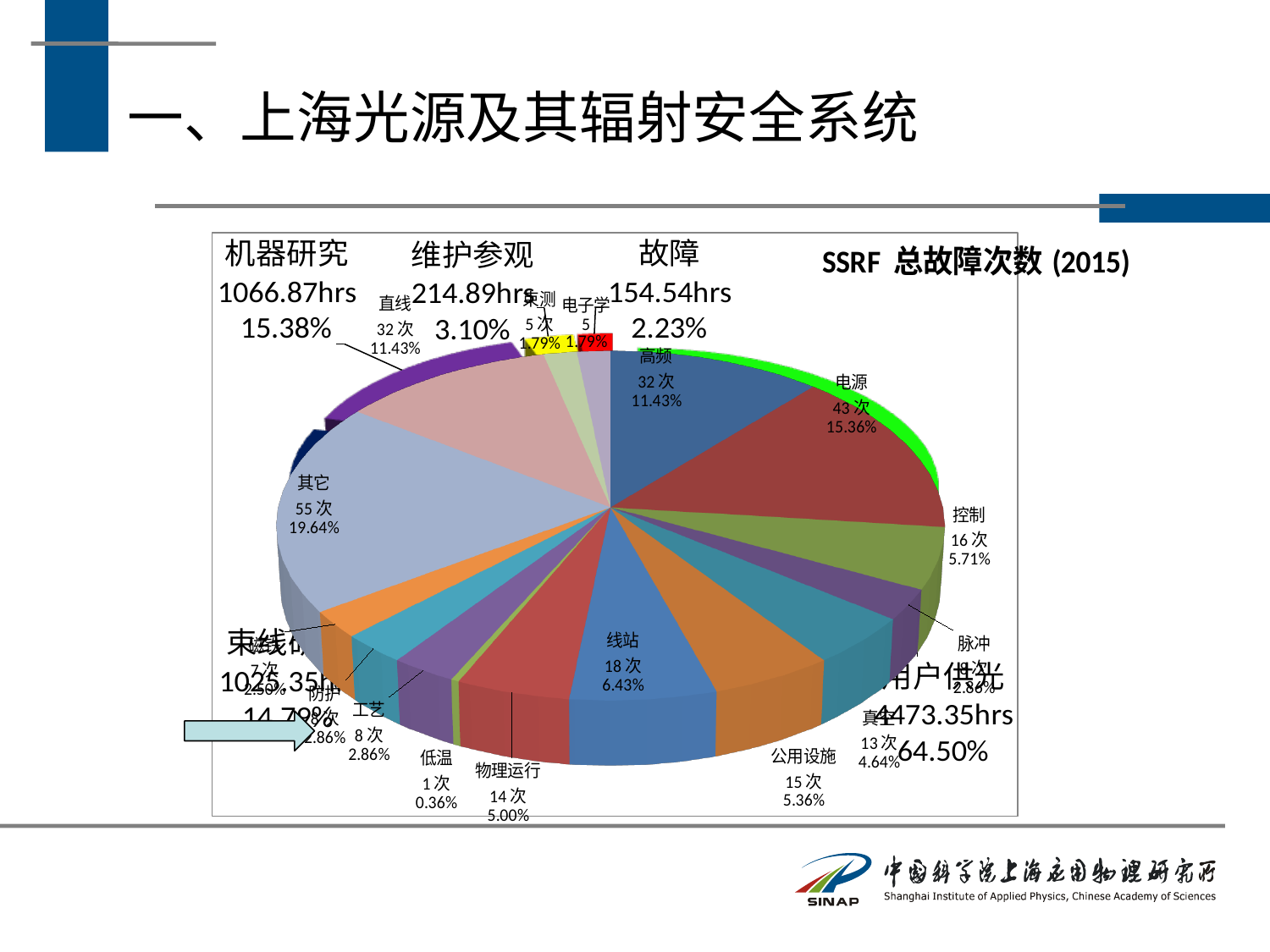
In the SSRF 总故障次数 (2015) pie chart, which has more failures, 电源 or 控制? 电源 In the SSRF 总故障次数 (2015) pie chart, how many failures are recorded for 物理运行? 14 次 In the SSRF 总故障次数 (2015) pie chart, what is the difference in failure counts between 电源 and 高频? 11 次 In the SSRF 总故障次数 (2015) pie chart, what share does 高频 account for? 11.43% In the SSRF 总故障次数 (2015) pie chart, what share does 其它 account for? 19.64% In the SSRF 总故障次数 (2015) pie chart, what share does 公用设施 account for? 5.36% What is the title of the pie chart? SSRF 总故障次数 (2015) In the SSRF 总故障次数 (2015) pie chart, which category has the largest number of failures? 其它 What kind of chart is shown on the slide? pie chart In the SSRF 总故障次数 (2015) pie chart, how many failures are recorded for 线站? 18 次 In the SSRF 总故障次数 (2015) pie chart, which category has the smallest number of failures? 低温 In the SSRF 总故障次数 (2015) pie chart, how many failures are recorded for 电源? 43 次